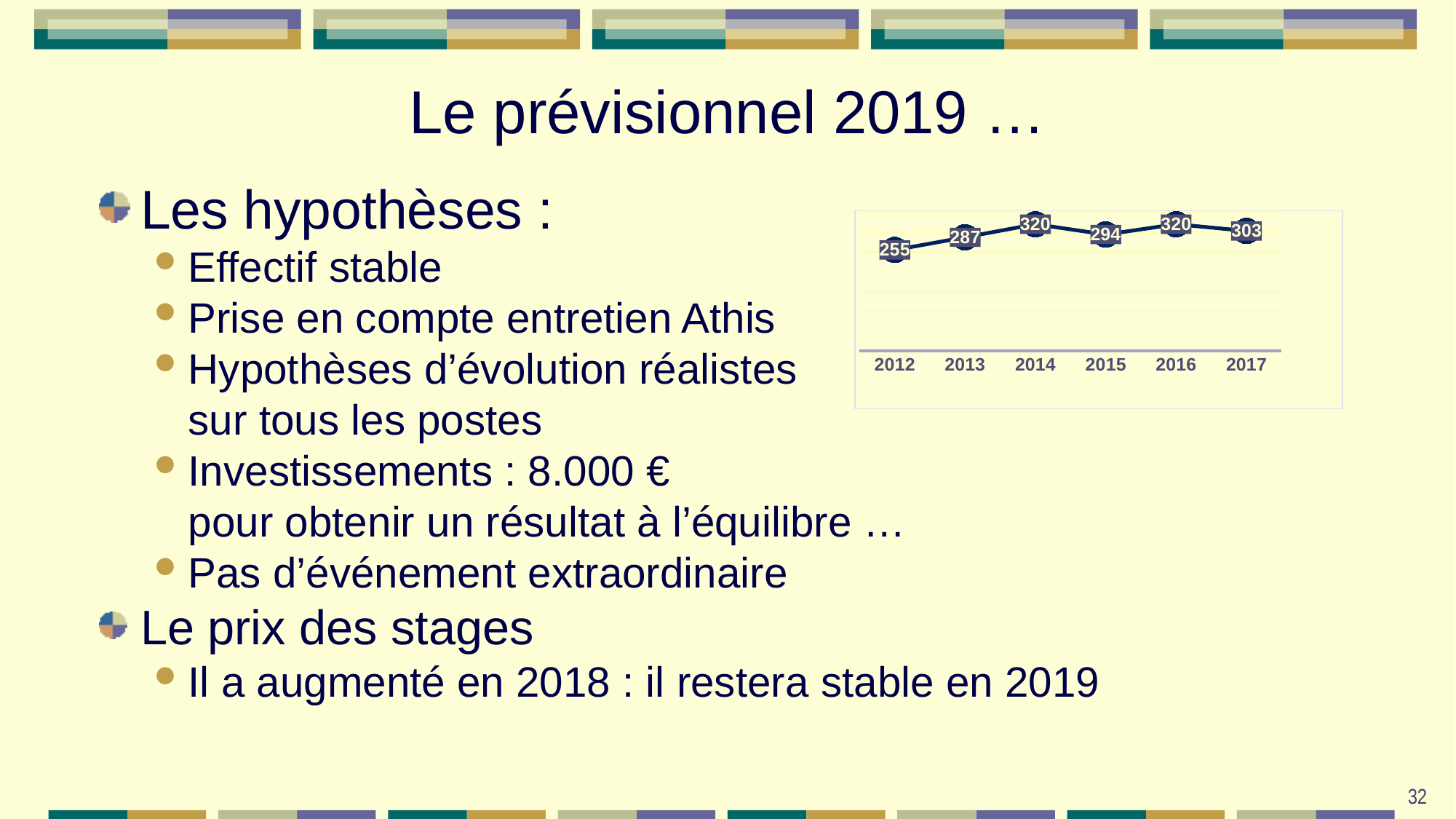
Which year has the lowest value in the chart? 2012 What is the difference between the values for 2014 and 2012? 65 What is the value for 2015 in the chart? 294 What is the value for 2012 in the chart? 255 Which is larger, the value for 2013 or the value for 2015? 2015 What is the highest value shown in the chart? 320 Does the value rise or fall from 2012 to 2014? rise What kind of chart is shown on the slide? line chart What is the difference between the values for 2016 and 2017? 17 What is the value for 2017 in the chart? 303 How many years are plotted on the x axis of the chart? 6 What is the value for 2013 in the chart? 287